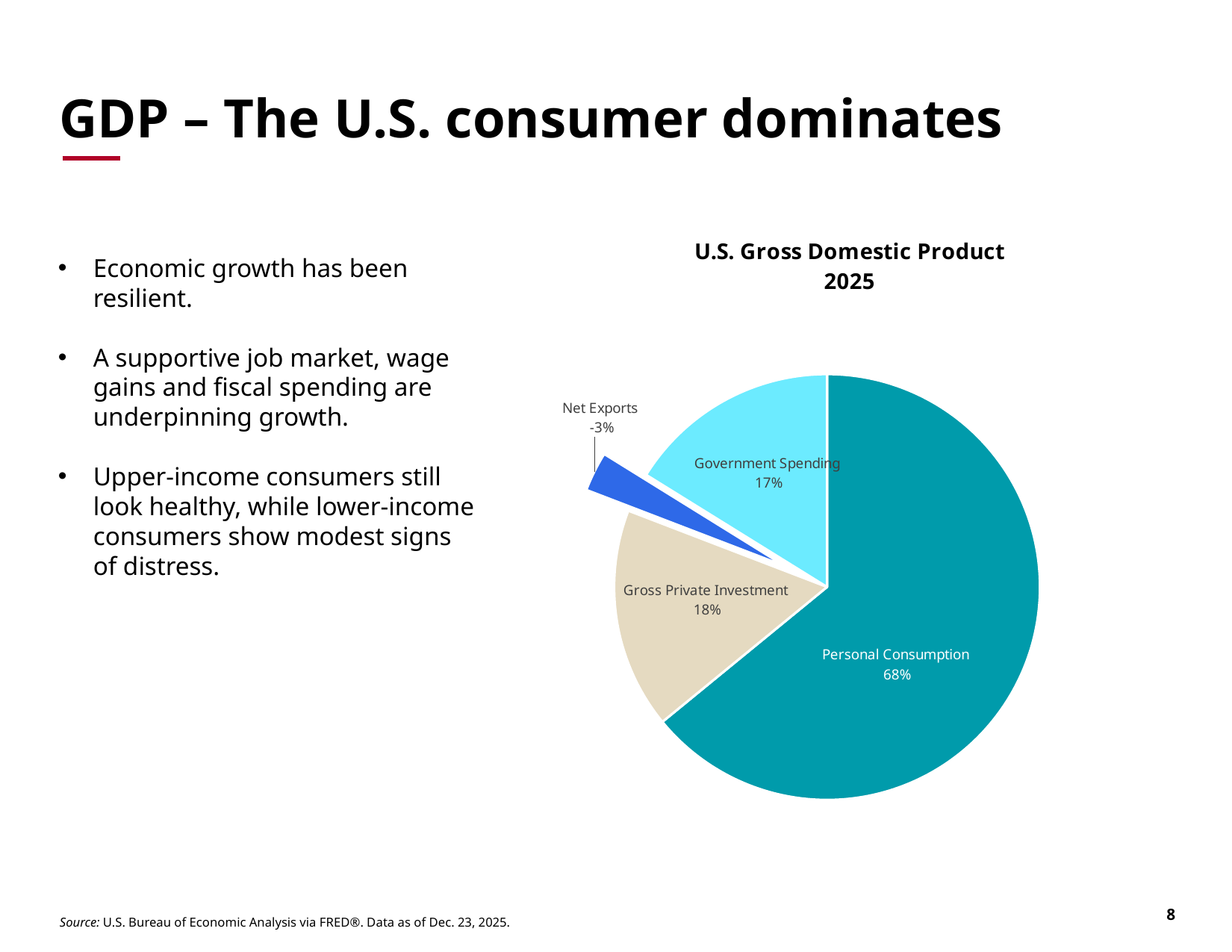
What share of the pie is Government Spending? 17% What share of U.S. Gross Domestic Product 2025 is Personal Consumption? 68% Which category has the smallest value in the chart? Net Exports Which category has the largest share of the pie? Personal Consumption What is the title of the chart? U.S. Gross Domestic Product 2025 What is the difference between the Gross Private Investment share and the Government Spending share? 1% What value is shown for Net Exports? -3% What kind of chart is shown on the slide? Pie chart What is the difference between the Personal Consumption share and the Gross Private Investment share? 50% How many categories are shown in the pie chart? 4 Which is larger, Personal Consumption or Government Spending? Personal Consumption What share of the pie is Gross Private Investment? 18%